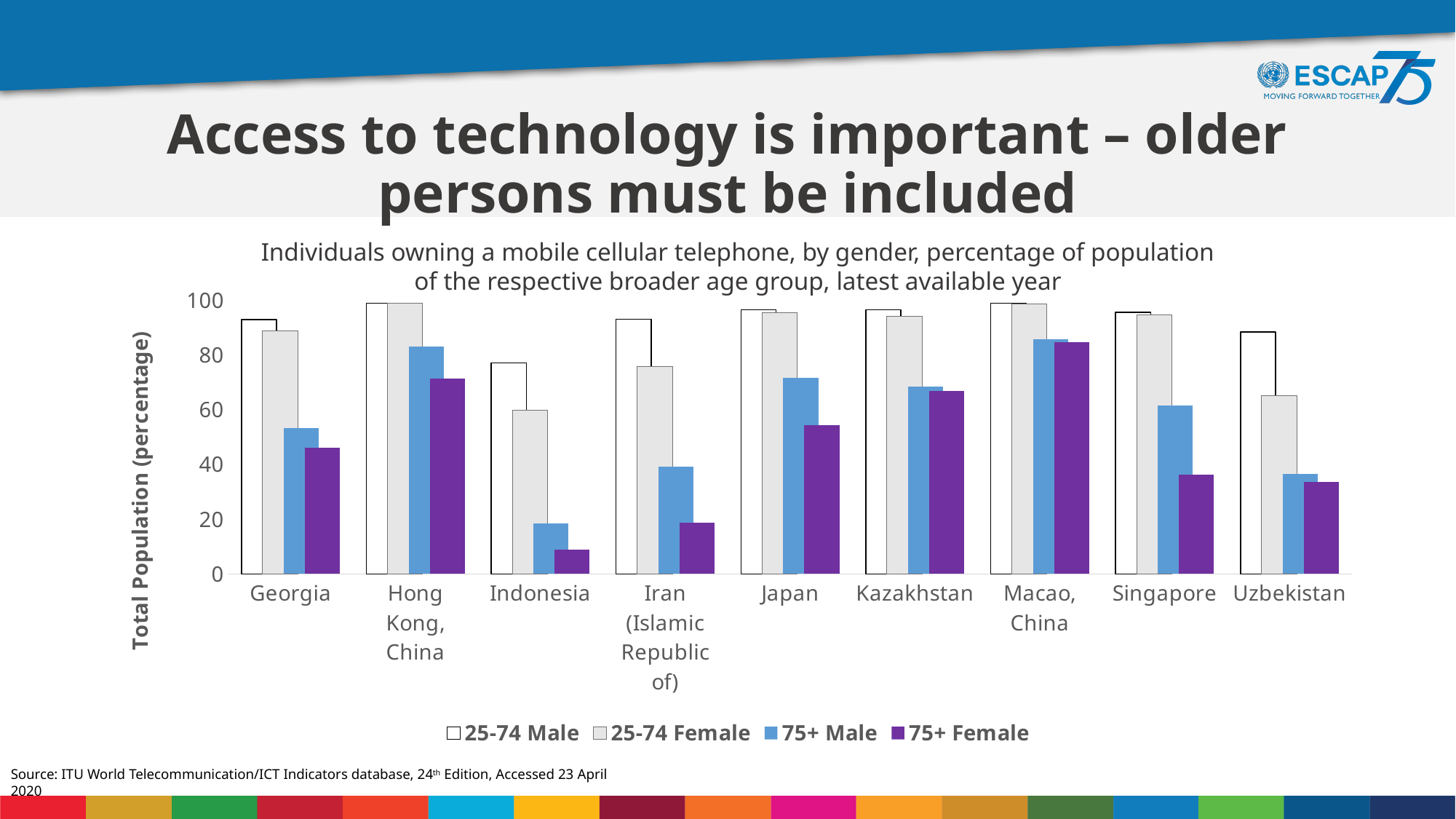
Which country has the lowest value for the 75+ Female series? Indonesia Which is larger, the 75+ Male value for Japan or the 75+ Male value for Georgia? Japan Which economy has the highest value for the 75+ Female series? Macao, China Is the 75+ Male value for Georgia greater or less than 40? greater How many series does the chart's legend list? 4 Which country has the lowest value for the 75+ Male series? Indonesia Is the 75+ Female value for Singapore greater or less than 40? less Is the 75+ Male value for Japan greater or less than 60? greater How many countries or economies are shown on the x axis of the chart? 9 What is the label of the chart's vertical axis? Total Population (percentage) Which country has the lowest value for the 25-74 Female series? Indonesia What kind of chart is shown on the slide? bar chart